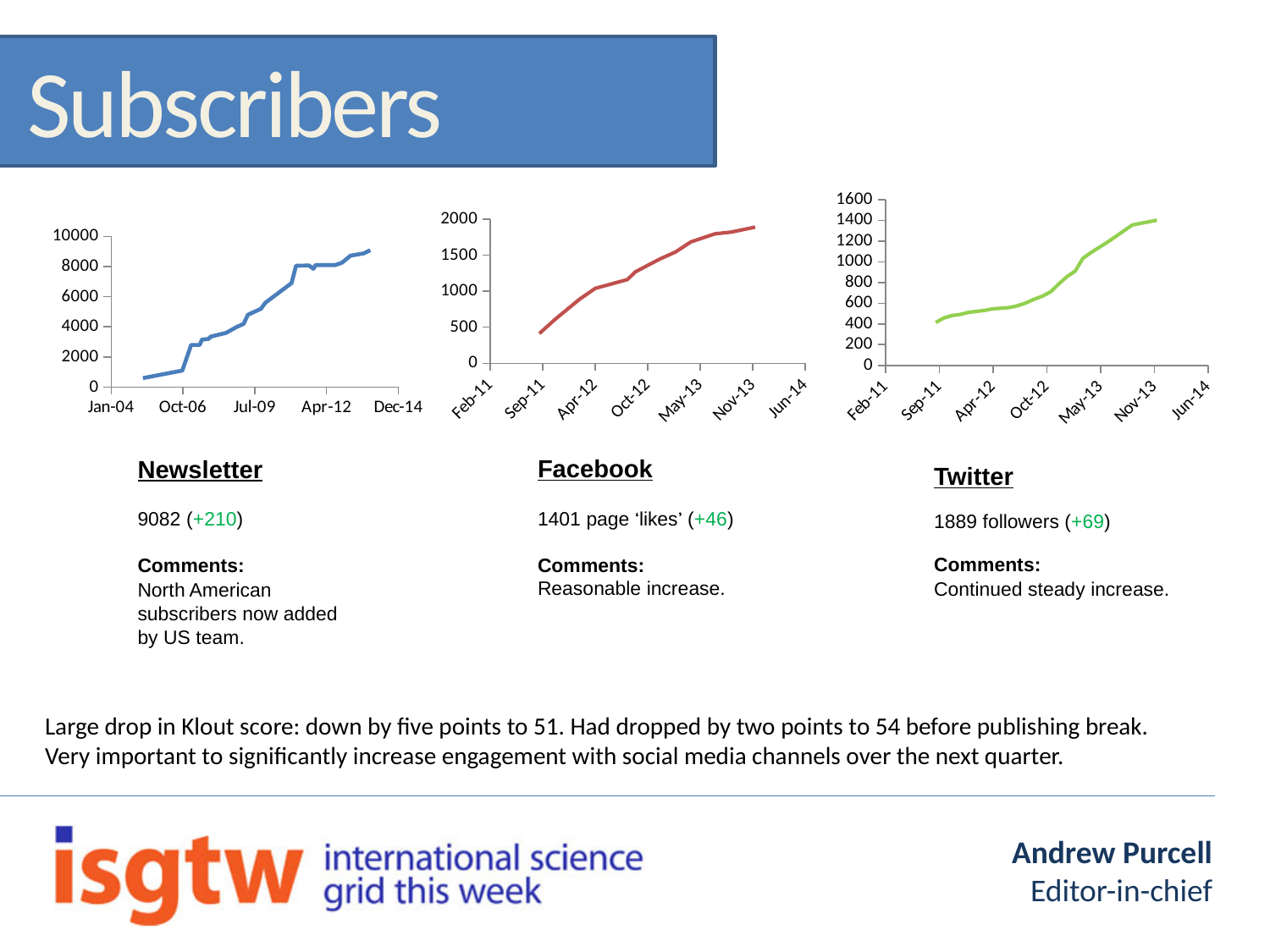
In the right-hand chart (green line), is the value at Nov-13 greater or less than 1200? greater In the right-hand chart (green line), is the value at Oct-12 greater or less than 800? less In the left-hand chart (blue line), is the value at Oct-06 greater or less than 2000? less How many charts are shown on the slide? 3 Which chart reaches a higher final value: the middle chart (red line) or the right-hand chart (green line)? the middle chart (red line) What kind of chart is the left-hand chart on the slide? line chart In the middle chart (red line), do the values rise or fall over time? rise What is the highest value shown on the y-axis of the right-hand chart (green line)? 1600 In the left-hand chart (blue line), do the values rise or fall from Jan-04 to Dec-14? rise